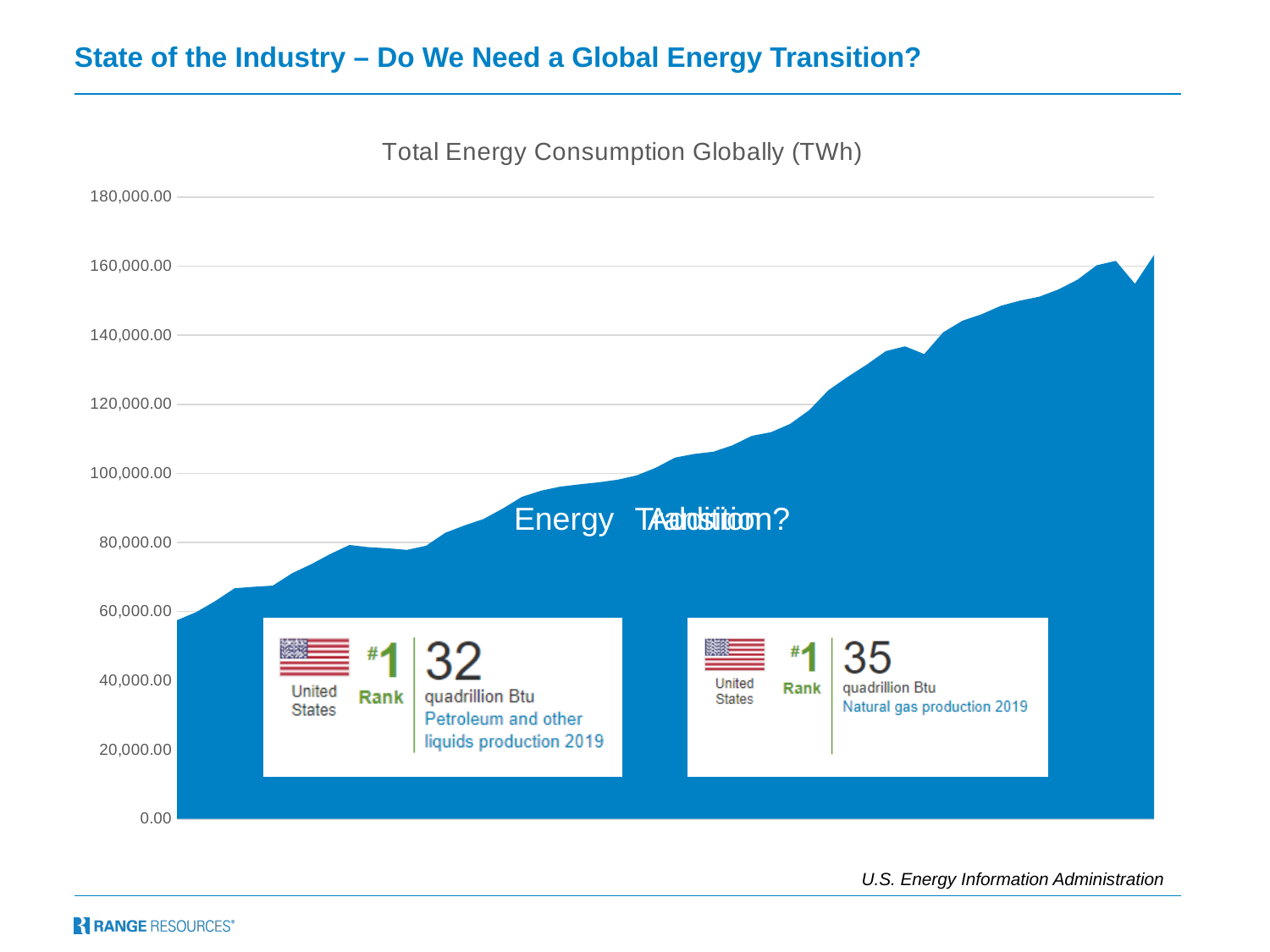
Is the lowest value plotted in the chart greater or less than 20,000.00? greater Is the value at the right end of the chart greater or less than 140,000.00? greater What kind of chart is shown on the slide? Area chart Which is larger, the value at the left end of the chart or the value at the right end? The right end Do the values in the chart generally rise or fall from left to right along the x axis? Rise Is the highest value plotted in the chart greater or less than 180,000.00? less What source is cited for the chart on the slide? U.S. Energy Information Administration What is the title of the chart? Total Energy Consumption Globally (TWh) How many data series are plotted in the chart? 1